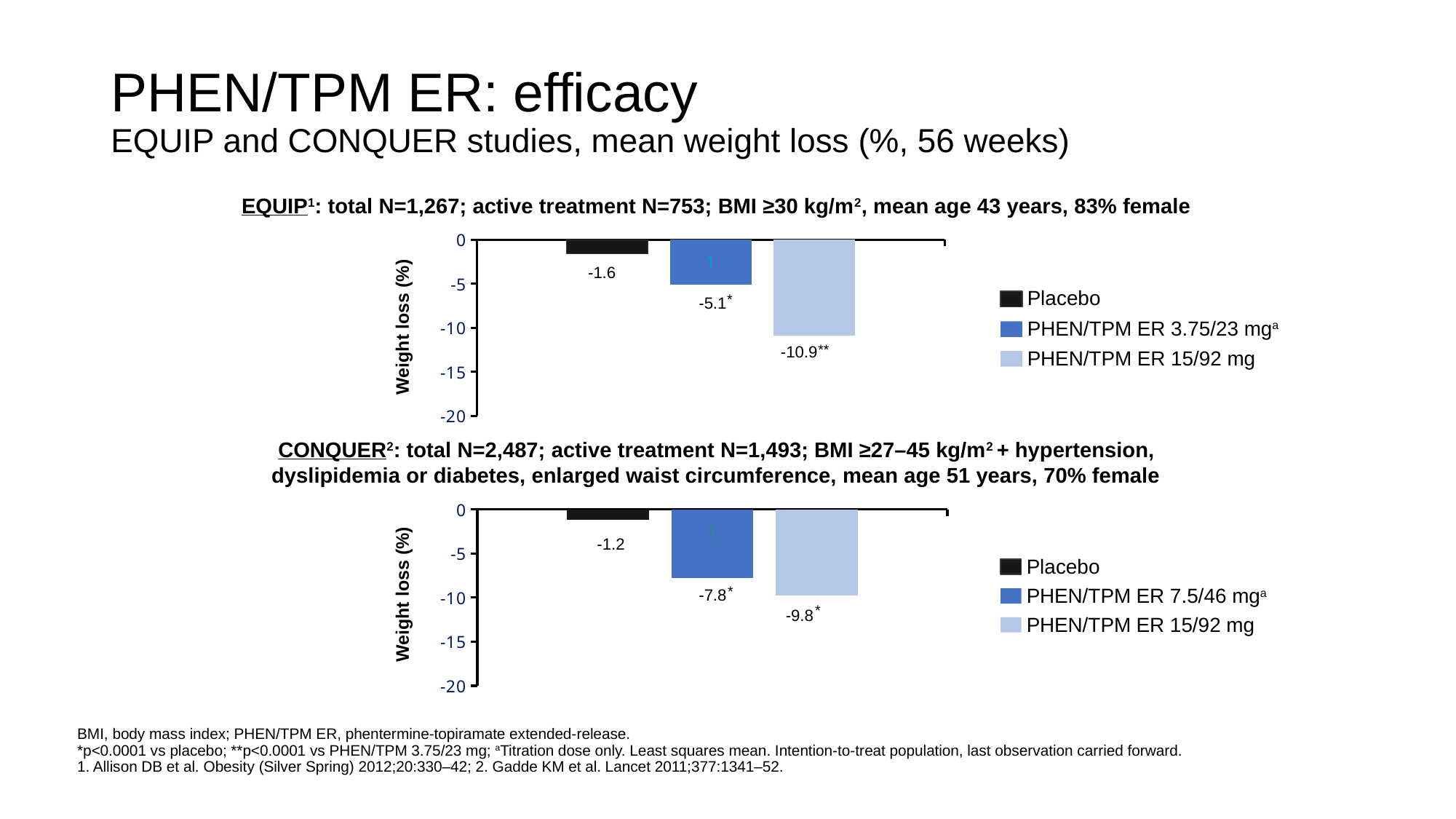
In the EQUIP chart, what is the mean weight loss for PHEN/TPM ER 15/92 mg? -10.9 In the EQUIP chart, what is the mean weight loss for Placebo? -1.6 In the CONQUER chart, what is the difference in weight loss between PHEN/TPM ER 15/92 mg and Placebo? 8.6 What is the y-axis label of the EQUIP chart? Weight loss (%) In the CONQUER chart, what is the mean weight loss for PHEN/TPM ER 7.5/46 mg? -7.8 In the CONQUER chart, what is the mean weight loss for Placebo? -1.2 What type of chart is used for the EQUIP study? Bar chart In the EQUIP chart, what is the difference in weight loss between PHEN/TPM ER 15/92 mg and PHEN/TPM ER 3.75/23 mg? 5.8 Which chart shows a larger weight loss for PHEN/TPM ER 15/92 mg, EQUIP or CONQUER? EQUIP How many series does the legend of the CONQUER chart list? 3 In the CONQUER chart, which treatment group shows the smallest weight loss? Placebo In the EQUIP chart, which treatment group shows the greatest weight loss? PHEN/TPM ER 15/92 mg